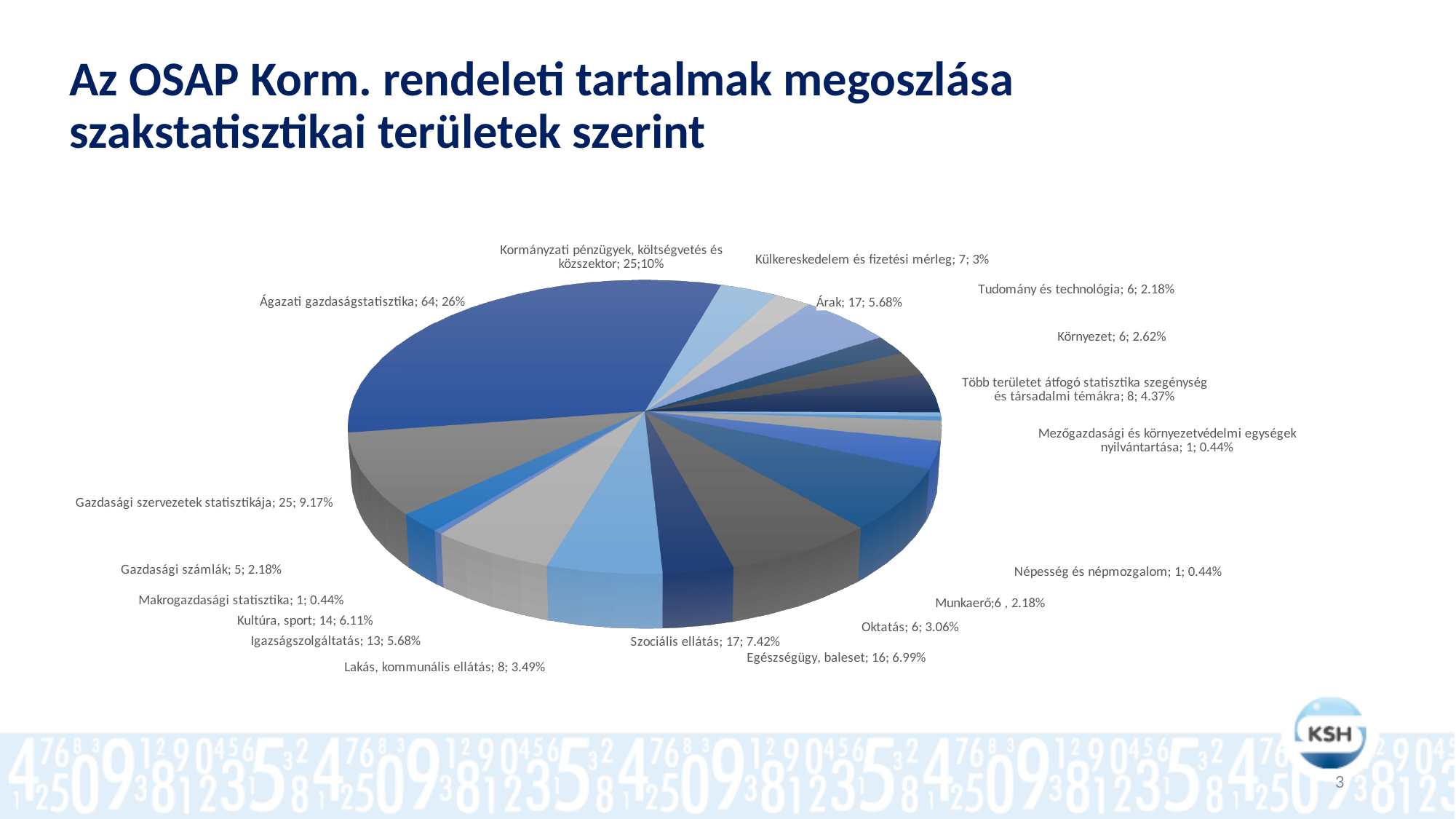
What count is shown for Szociális ellátás? 17 What kind of chart is shown on the slide? pie chart What percentage is shown for Több területet átfogó statisztika szegénység és társadalmi témákra? 4.37% What count is shown for Ágazati gazdaságstatisztika? 64 What percentage is shown for Egészségügy, baleset? 6.99% What share of the pie does Ágazati gazdaságstatisztika represent? 26% How many categories (slices) does the pie chart have? 19 Which category has the largest slice in the pie chart? Ágazati gazdaságstatisztika What is the title of the slide containing the pie chart? Az OSAP Korm. rendeleti tartalmak megoszlása szakstatisztikai területek szerint What is the difference in count between Ágazati gazdaságstatisztika and Gazdasági szervezetek statisztikája? 39 Which has a larger count, Igazságszolgáltatás or Kultúra, sport? Kultúra, sport What count is shown for Kultúra, sport? 14